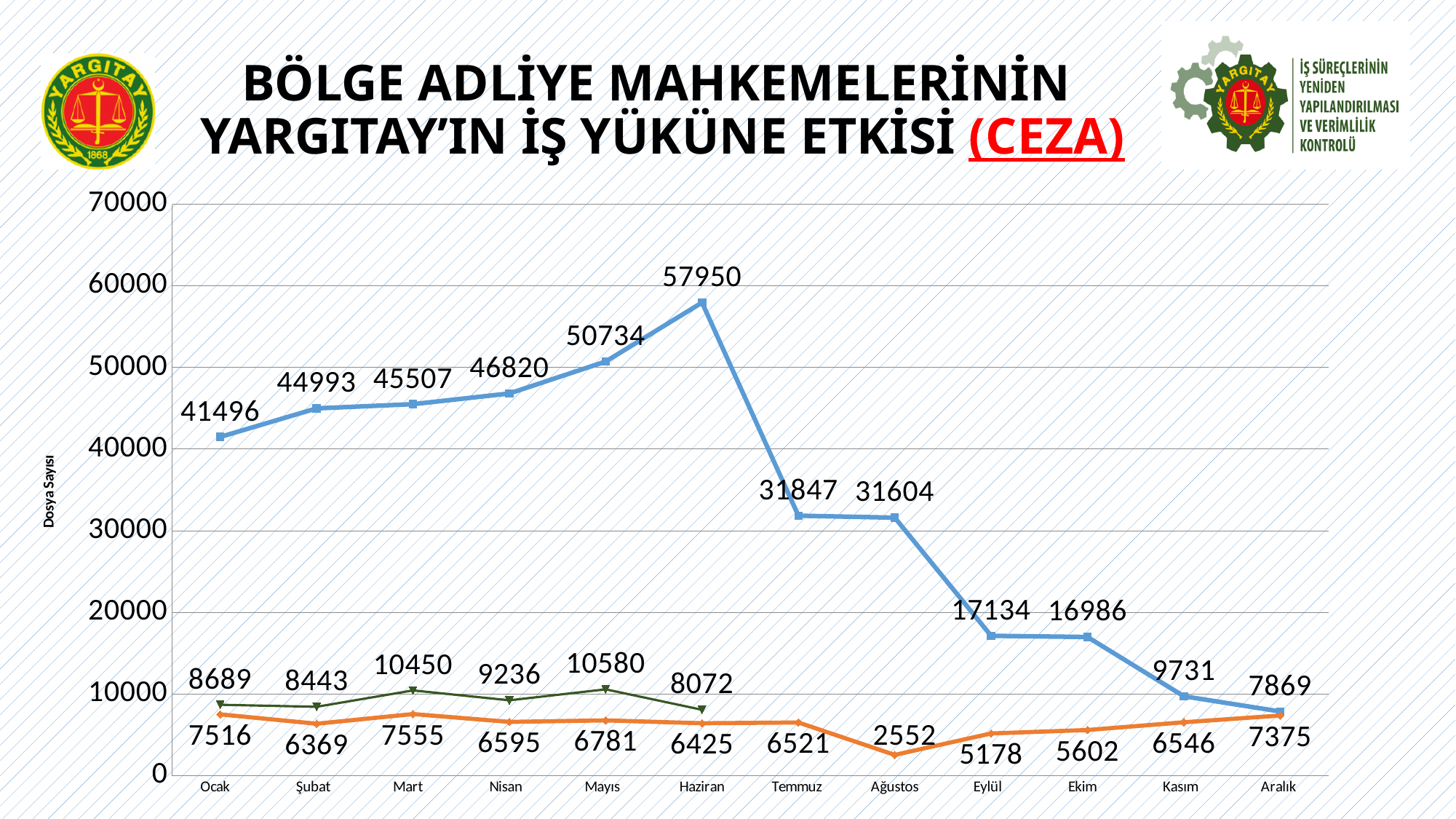
Does the blue line rise or fall from Haziran to Aralık? fall Is the blue line's value for Eylül greater or less than 20000? less What is the value of the green line for Mayıs? 10580 What is the difference between the blue line's values for Haziran and Temmuz? 26103 What type of chart is shown on the slide? line chart What is the value of the orange line for Ağustos? 2552 What is the value of the blue line for Haziran? 57950 In which month does the blue line reach its highest value? Haziran What is the label of the vertical axis? Dosya Sayısı How many months are shown on the x axis? 12 In which month does the orange line have its lowest value? Ağustos Which is larger: the blue line's value for Şubat or for Mart? Mart